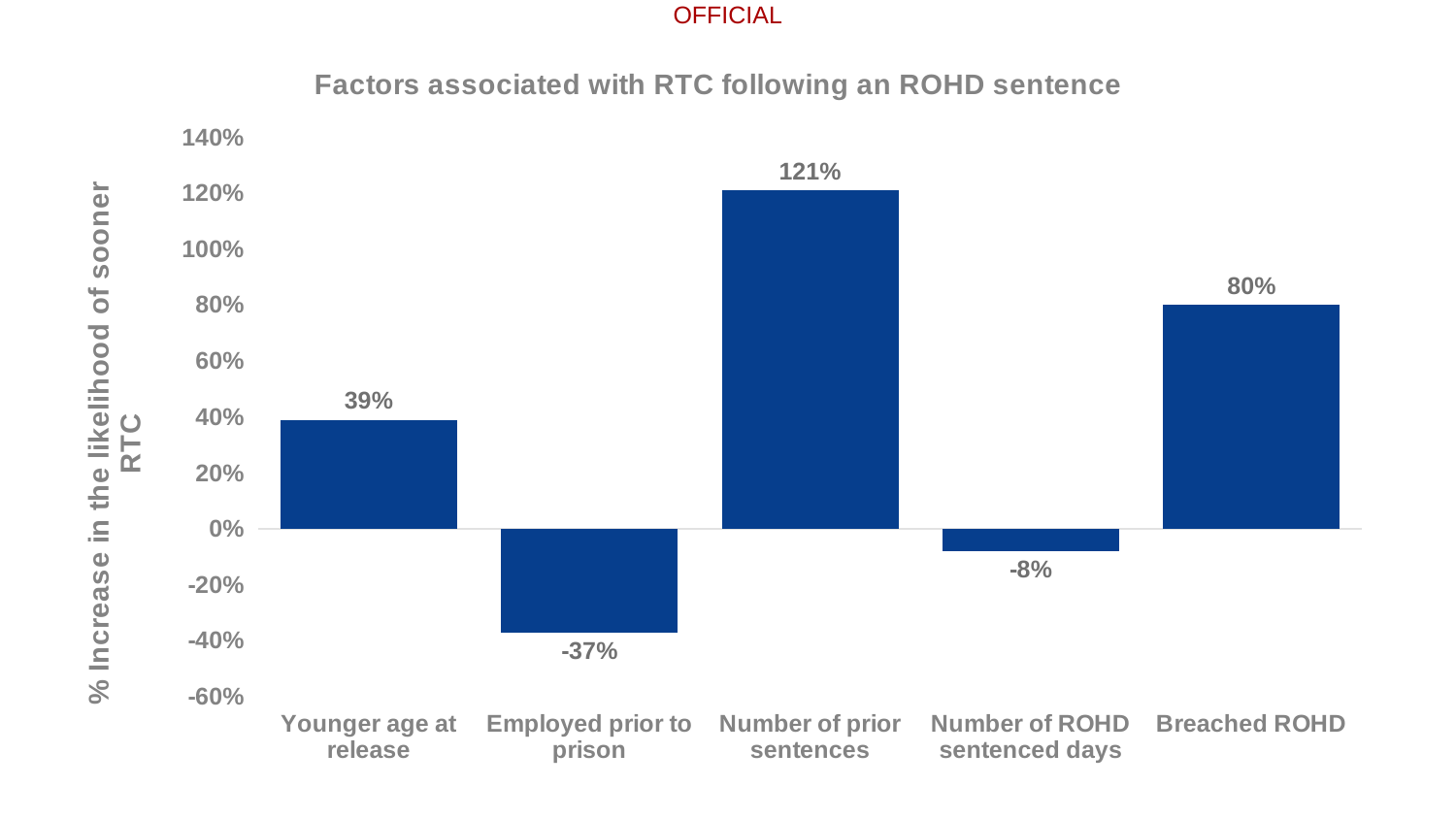
How many factors are shown on the chart? 5 Is the value for Younger age at release greater or less than 60%? less Which is larger, the value for Younger age at release or the value for Breached ROHD? Breached ROHD What is the value for Employed prior to prison? -37% What kind of chart is this? bar chart What is the value for Number of prior sentences? 121% Which factor has the highest value? Number of prior sentences What is the value for Number of ROHD sentenced days? -8% What is the title of the chart? Factors associated with RTC following an ROHD sentence Which factor has the lowest value? Employed prior to prison What is the difference between the values for Number of prior sentences and Breached ROHD? 41% What is the value for Breached ROHD? 80%